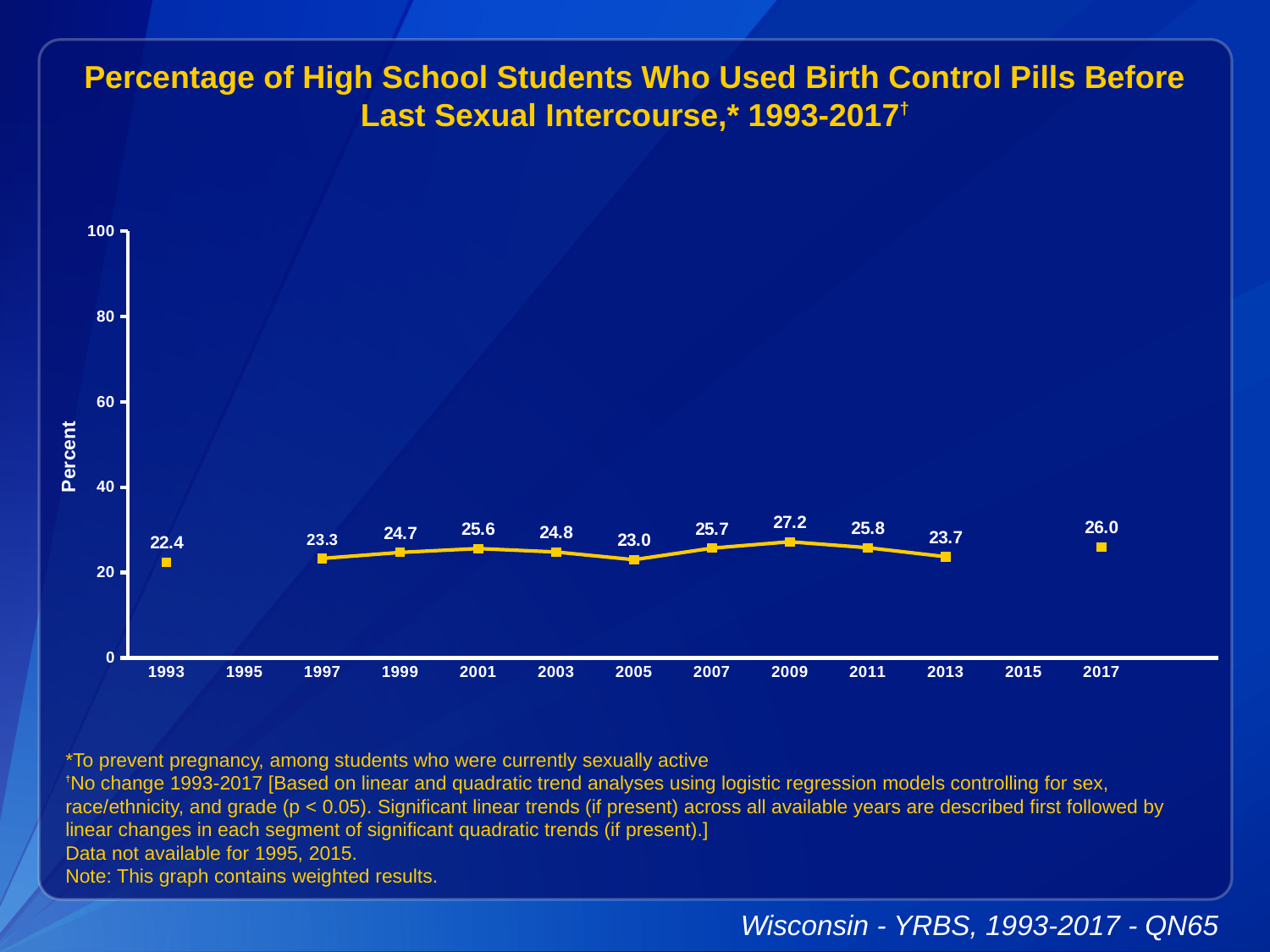
How many years have data points plotted on the chart? 11 What value is shown for 2017? 26.0 What is the difference between the values for 2009 and 2005? 4.2 Which year has a larger value, 2001 or 2013? 2001 What was the percentage of high school students who used birth control pills before last sexual intercourse in 1993? 22.4 What value is shown for 2009? 27.2 Which year has the lowest value on the chart? 1993 What kind of chart is shown on the slide? Line chart Is the value for 2011 greater or less than 40? less Which year has the highest value on the chart? 2009 Did the value rise or fall from 2011 to 2013? Fall What is the label on the y-axis of the chart? Percent